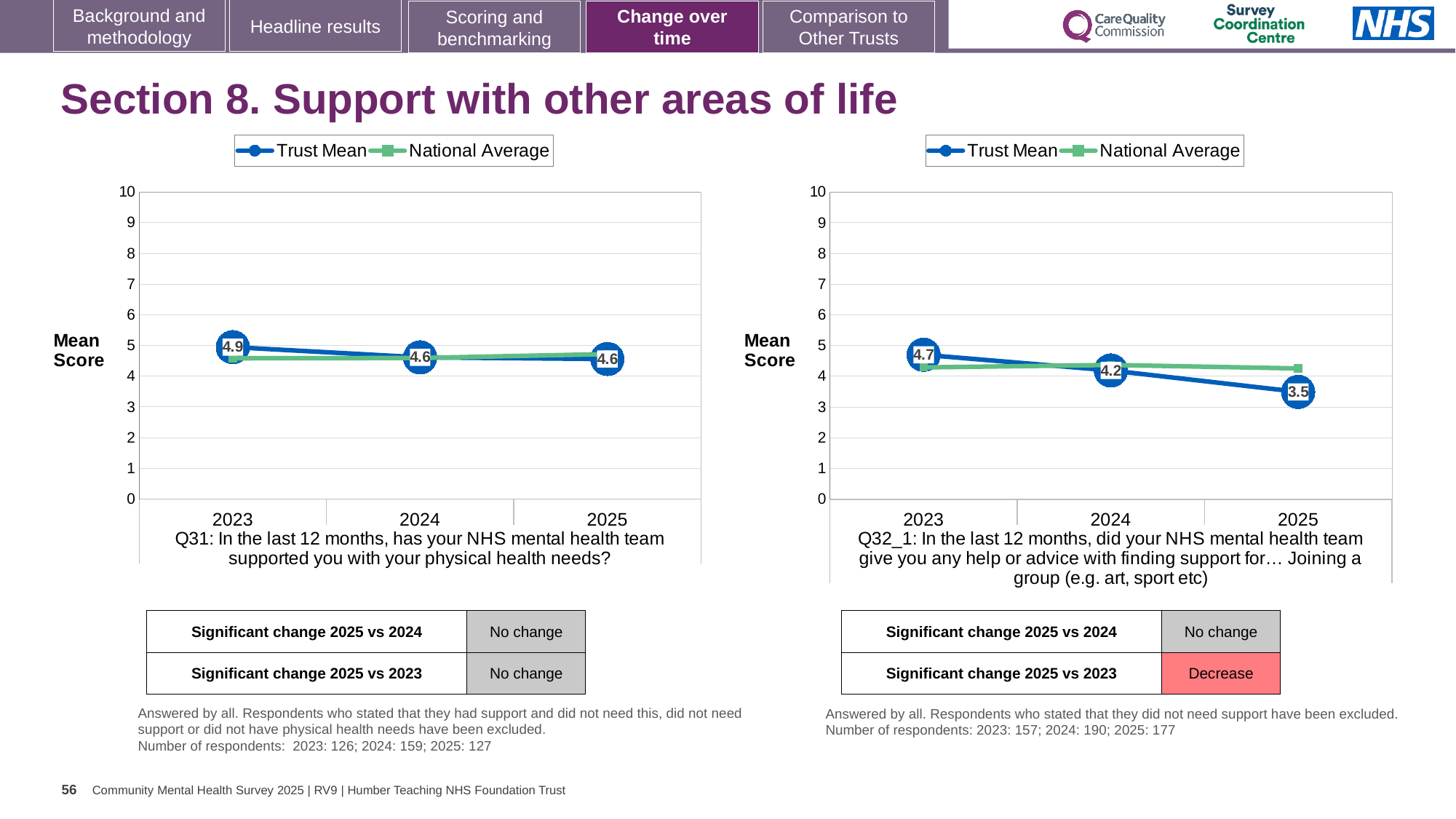
In the right chart (Q32_1), is the National Average for 2025 greater or less than 4? greater In the left chart (Q31), what is the Trust Mean score for 2023? 4.9 In the right chart (Q32_1), what is the Trust Mean score for 2025? 3.5 In the right chart (Q32_1), what is the Trust Mean score for 2024? 4.2 In the left chart (Q31), which year has the highest Trust Mean score? 2023 In the right chart (Q32_1), does the Trust Mean rise or fall from 2023 to 2025? fall In the right chart (Q32_1), which year has the lowest Trust Mean score? 2025 In the left chart (Q31), what is the difference between the Trust Mean in 2023 and in 2024? 0.3 In the left chart (Q31), what is the Trust Mean score for 2025? 4.6 In the right chart (Q32_1), by how much did the Trust Mean fall from 2023 to 2025? 1.2 What type of chart is used for Q32_1 on the right? line chart How many series does the legend of the left chart (Q31) list? 2